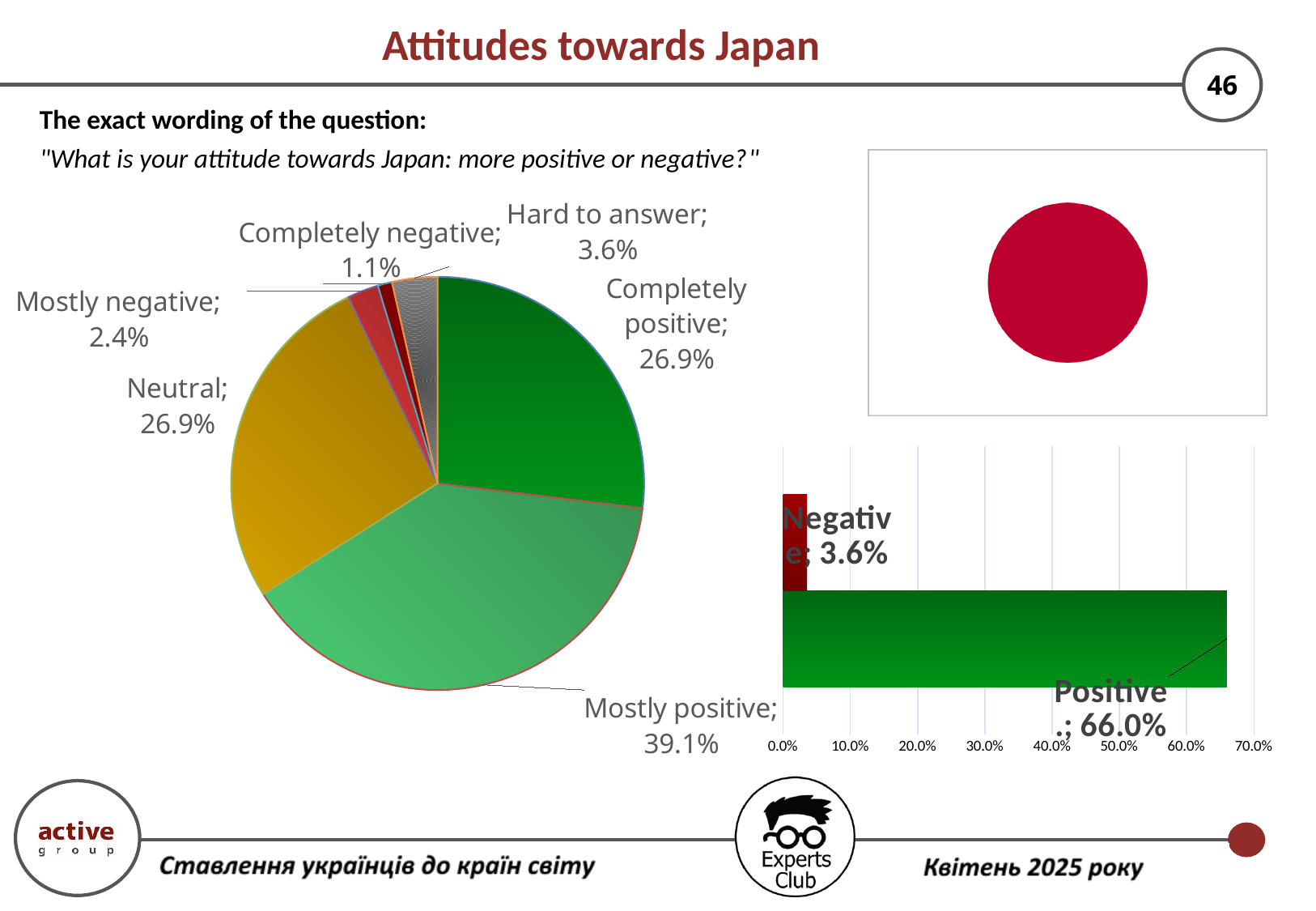
In the pie chart, which is larger: 'Mostly negative' or 'Hard to answer'? Hard to answer In the pie chart, what share of respondents answered 'Neutral'? 26.9% What type of chart is shown on the right side of the slide? Bar chart How many categories does the pie chart show? 6 In the pie chart, which category has the largest share? Mostly positive In the pie chart, what share of respondents answered 'Completely negative'? 1.1% In the bar chart on the right, what is the value for 'Positive'? 66.0% In the bar chart on the right, what is the value for 'Negative'? 3.6% In the pie chart, what is the difference between the 'Mostly positive' and 'Completely positive' shares? 12.2 percentage points In the pie chart, which category has the smallest share? Completely negative In the pie chart, what share of respondents answered 'Mostly positive'? 39.1% In the pie chart, what share of respondents answered 'Hard to answer'? 3.6%